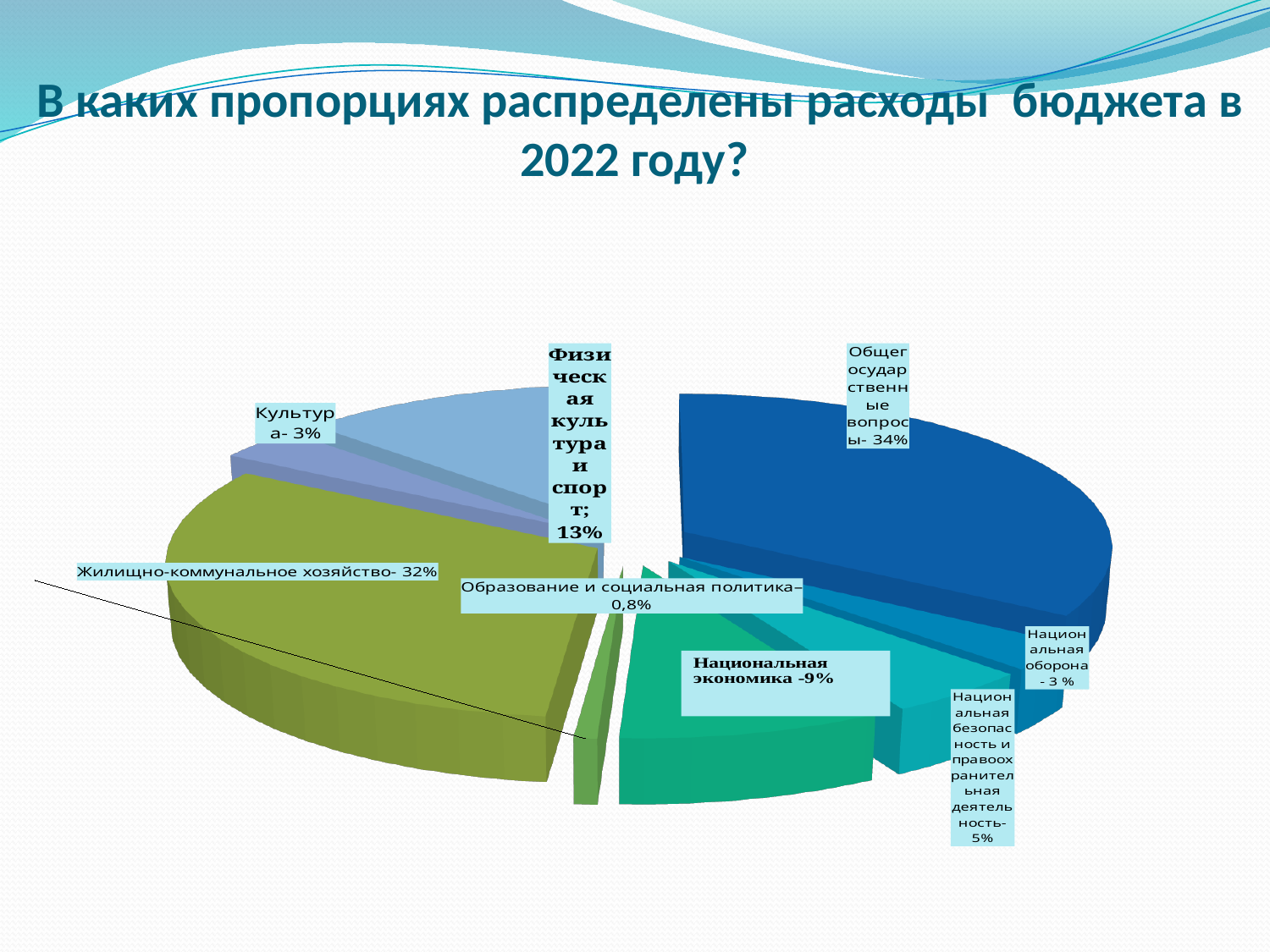
How many categories are shown in the pie chart? 8 Which category has the largest share of the budget expenses? Общегосударственные вопросы What share of the budget expenses goes to Общегосударственные вопросы? 34% What share of the budget expenses goes to Образование и социальная политика? 0,8% Which is larger: the share for Физическая культура и спорт or the share for Национальная экономика? Физическая культура и спорт What share of the budget expenses goes to Физическая культура и спорт? 13% What share of the budget expenses goes to Национальная безопасность и правоохранительная деятельность? 5% What share of the budget expenses goes to Жилищно-коммунальное хозяйство? 32% Which category has the smallest share of the budget expenses? Образование и социальная политика What kind of chart is shown on the slide? pie chart What is the difference in percentage points between Общегосударственные вопросы and Жилищно-коммунальное хозяйство? 2 What share of the budget expenses goes to Национальная экономика? 9%